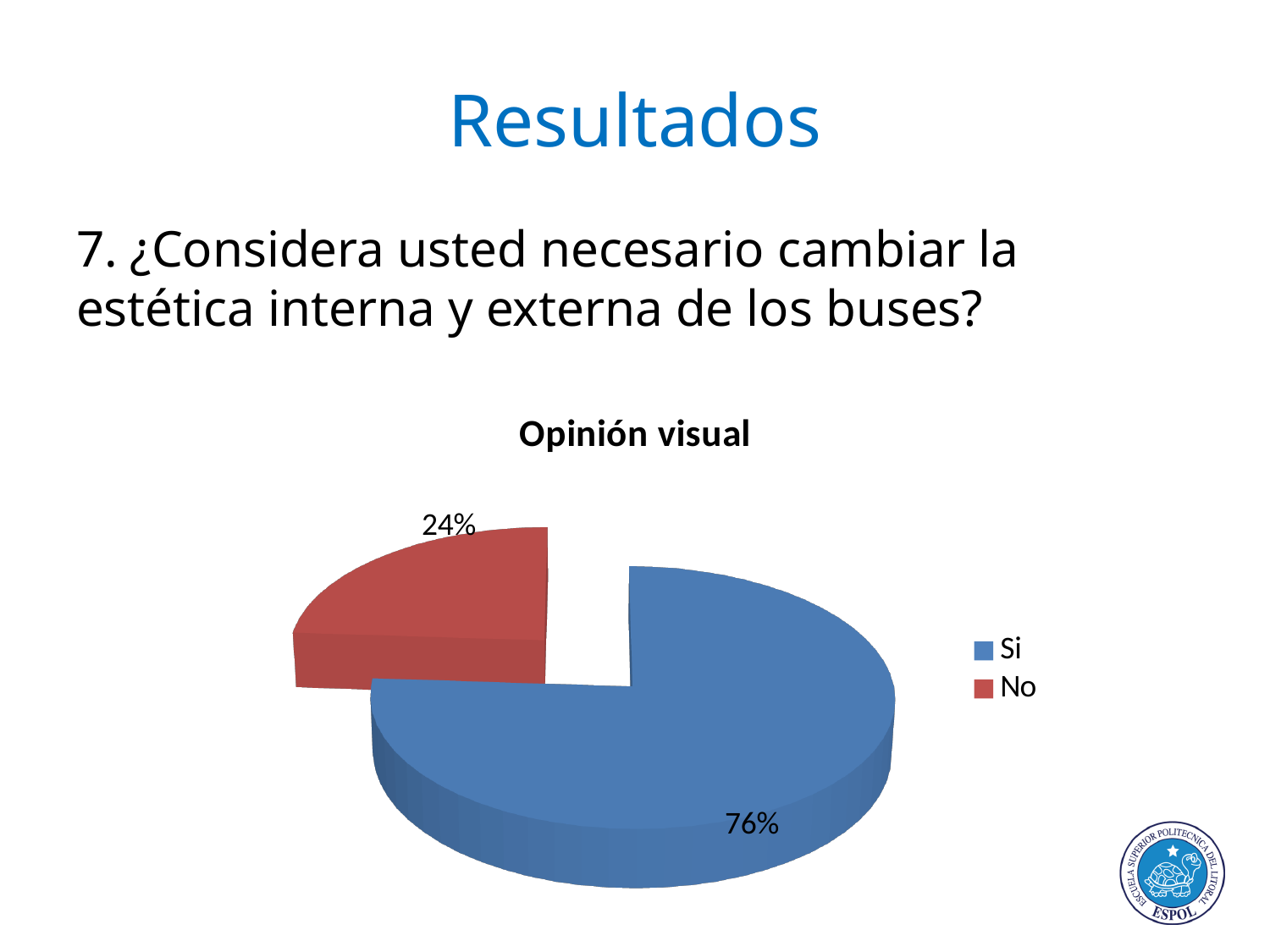
How many entries does the chart legend list? 2 What percentage of the pie chart corresponds to "No"? 24% What is the difference in percentage points between the "Si" and "No" slices? 52 What colour is the "No" slice in the pie chart? Red Is the share for "Si" greater or less than 50%? greater Which category has the largest share of the pie chart? Si What percentage of the pie chart corresponds to "Si"? 76% What is the title of the chart? Opinión visual How many categories are shown in the pie chart? 2 Which category has the smallest share of the pie chart? No Which slice is larger, "Si" or "No"? Si What type of chart is shown on the slide? Pie chart